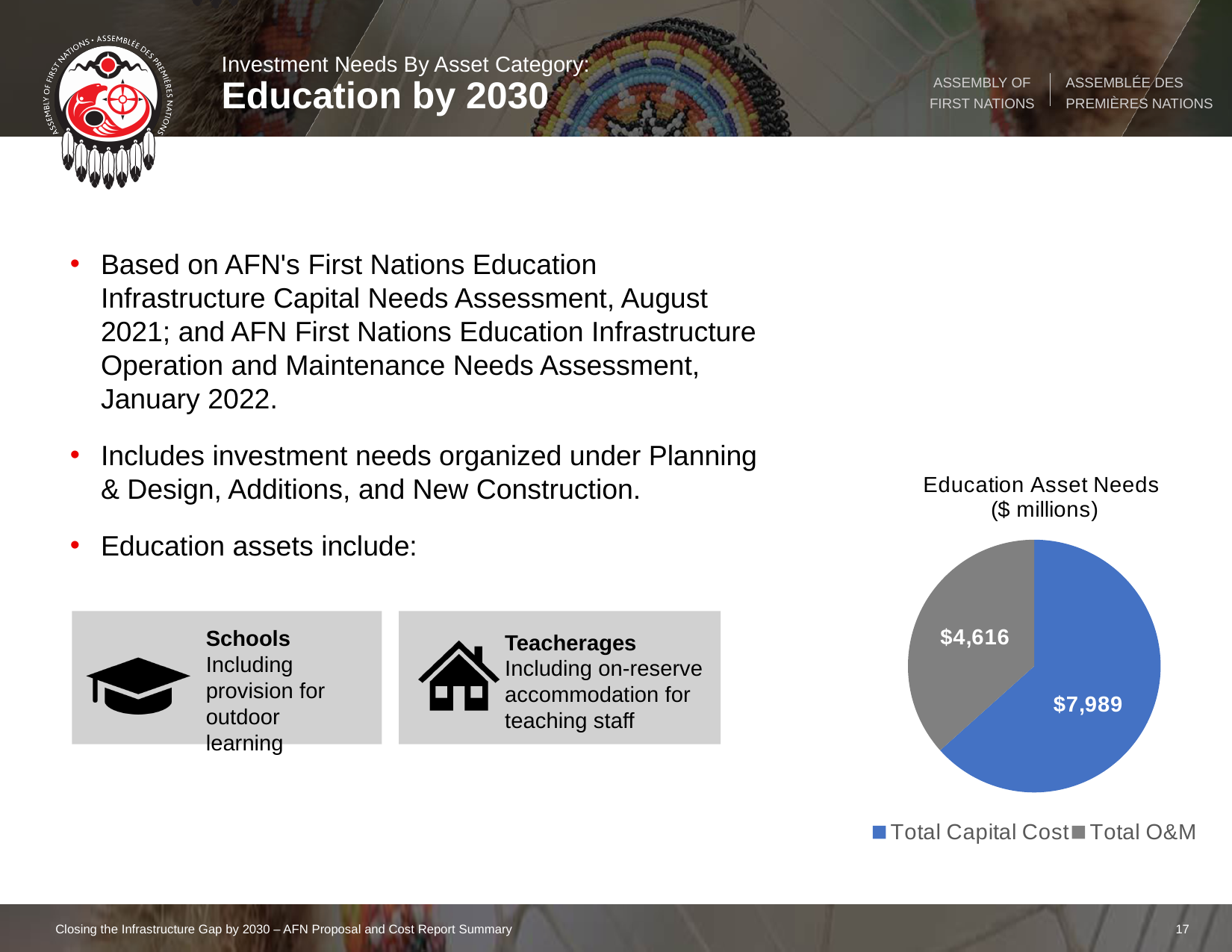
What is the value for Total Capital Cost in the Education Asset Needs pie chart? $7,989 How many entries does the legend of the Education Asset Needs chart list? 2 In the Education Asset Needs chart, which is larger: Total Capital Cost or Total O&M? Total Capital Cost Which slice of the Education Asset Needs pie chart is the smallest? Total O&M What colour is the Total O&M slice in the Education Asset Needs pie chart? Grey What kind of chart is used to show Education Asset Needs? Pie chart How many slices does the Education Asset Needs pie chart have? 2 What is the difference between Total Capital Cost and Total O&M in the Education Asset Needs chart? $3,373 What is the combined total of the two slices in the Education Asset Needs pie chart? $12,605 Which slice of the Education Asset Needs pie chart is the largest? Total Capital Cost What unit is stated in the title of the Education Asset Needs chart? $ millions What is the value for Total O&M in the Education Asset Needs pie chart? $4,616